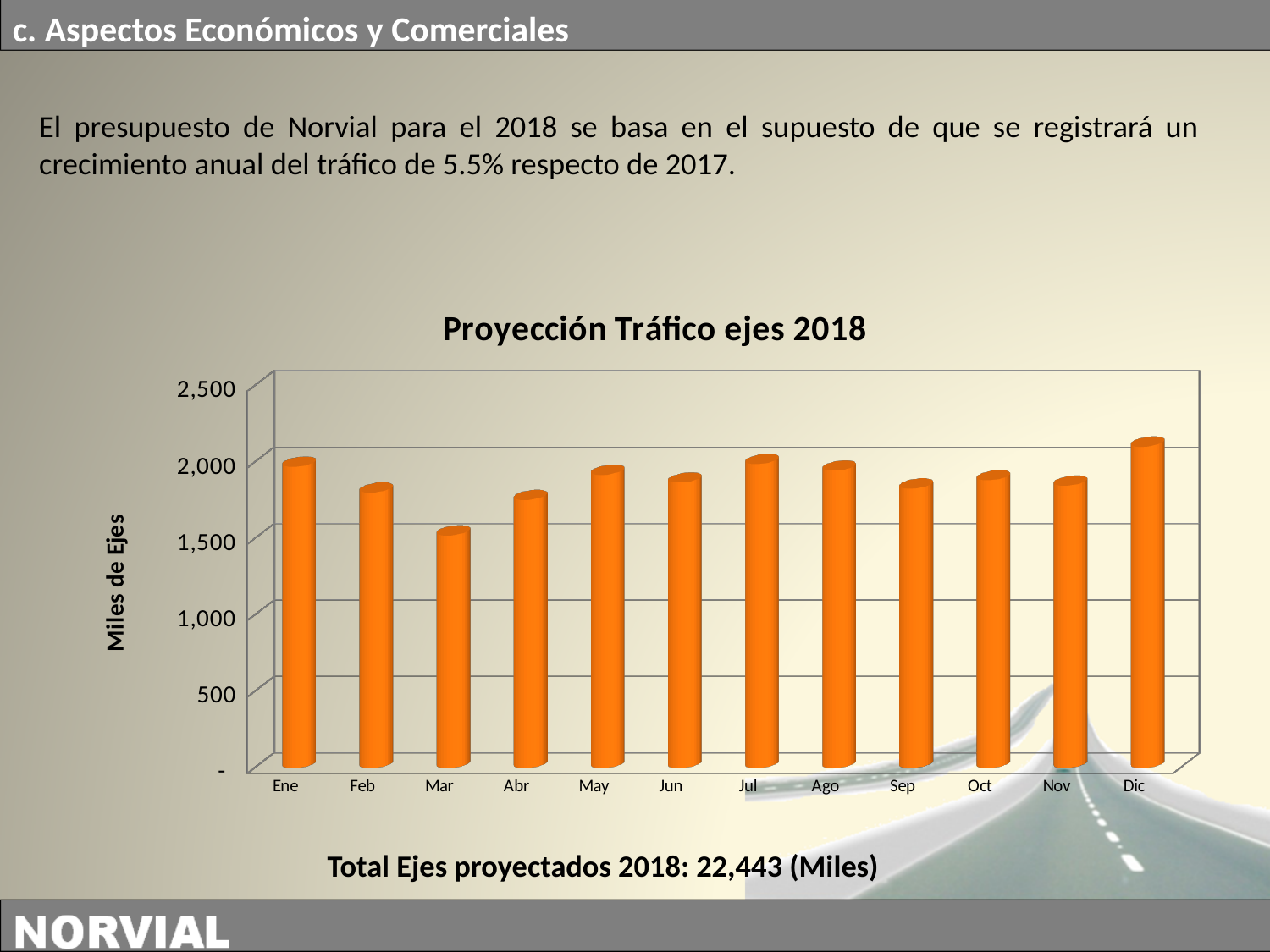
What is the title of the chart? Proyección Tráfico ejes 2018 How many months are plotted on the x axis of the chart? 12 Which month has the highest projected value in the chart? Dic What is the label on the vertical axis of the chart? Miles de Ejes Is the value for Feb greater or less than 1,000? greater Which is larger, the value for Mar or the value for Jul? Jul Which month has the lowest projected value in the chart? Mar Which is larger, the value for Dic or the value for Mar? Dic Is the value for Dic greater or less than 2,000? greater What type of chart is shown on the slide? bar chart Is the value for Mar greater or less than 2,000? less